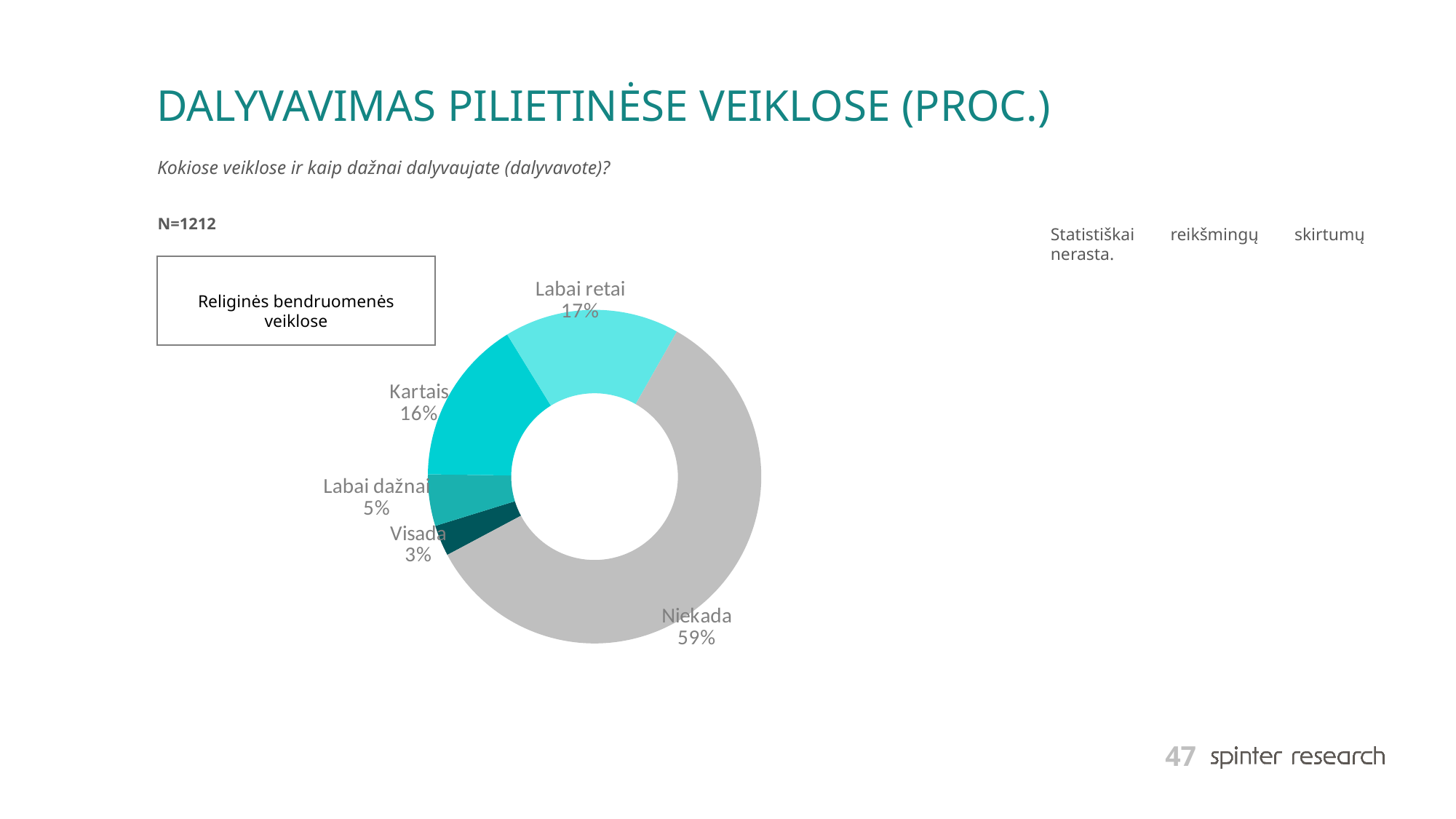
How many categories are shown in the chart? 5 What share of the donut chart is labelled "Labai retai"? 17% Which is larger, the share for "Labai dažnai" or the share for "Visada"? Labai dažnai What is the value shown for "Visada"? 3% What is the value shown for "Kartais"? 16% What percentage of respondents answered "Niekada" for participation in religious community activities? 59% Which activity does the chart refer to, according to the box on the left? Religinės bendruomenės veiklose What type of chart is shown on the slide? Donut (pie) chart Which category has the largest share of the chart? Niekada Which category has the smallest share of the chart? Visada What is the sample size (N) stated on the slide? N=1212 What is the difference in percentage points between "Niekada" and "Labai retai"? 42